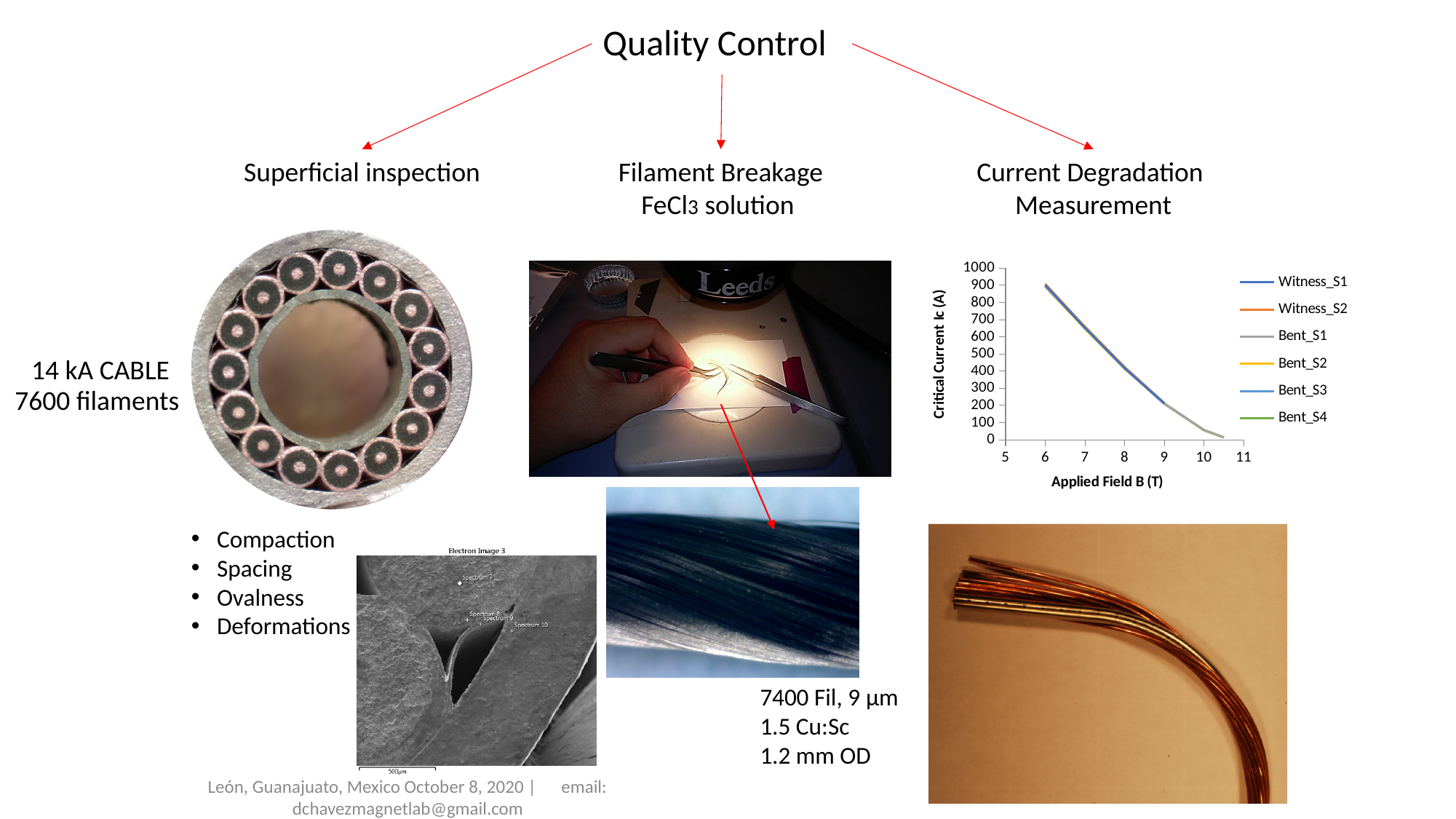
In the Critical Current chart, is the critical current at an applied field of 9 T greater or less than 300? less What is the label of the y axis of the Critical Current chart? Critical Current Ic (A) In the Critical Current chart, is the critical current higher at 6 T or at 9 T? 6 T In the Critical Current chart, is the critical current at an applied field of 6 T greater or less than 800? greater In the Critical Current chart, do the values rise or fall as the applied field increases? fall In the Critical Current chart, is the critical current at an applied field of 8 T greater or less than 600? less What kind of chart is shown under Current Degradation Measurement? line chart How many series does the legend of the Critical Current chart list? 6 What is the label of the x axis of the Critical Current chart? Applied Field B (T)